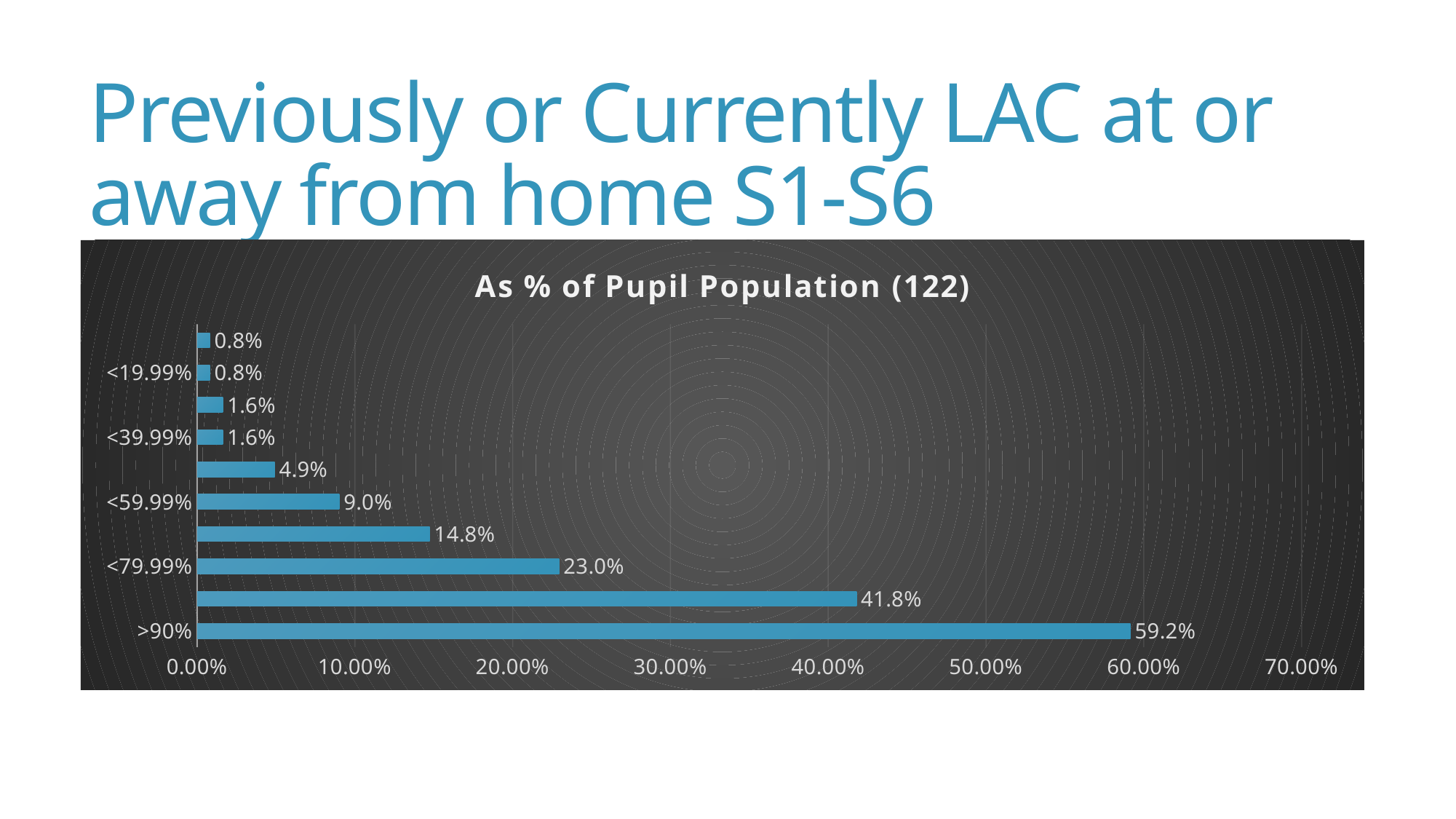
What is the difference between the values for >90% and <79.99%? 36.2% Is the value for >90% greater or less than 50.00%? greater What is the value for the <79.99% category? 23.0% Which is larger, the value for <59.99% or the value for <39.99%? <59.99% What is the value for the <39.99% category? 1.6% What is the value for the >90% category? 59.2% What is the value for the <59.99% category? 9.0% How many bars are plotted on the chart? 10 Which labelled category has the highest value? >90% What is the value for the <19.99% category? 0.8% What is the largest value shown on the chart? 59.2% What is the title of the chart? As % of Pupil Population (122)